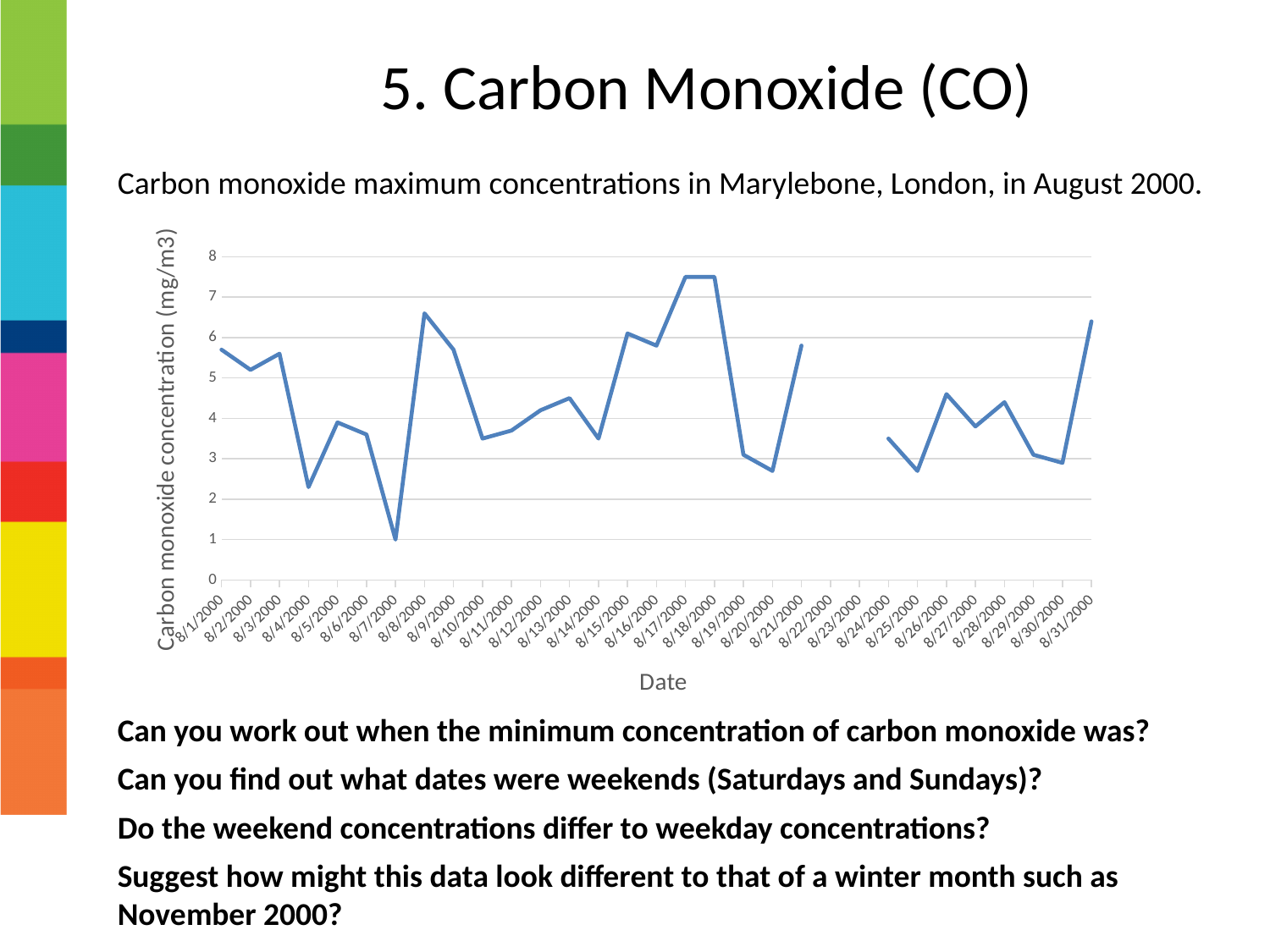
Is the value for 8/17/2000 greater or less than 7? greater What is the label of the y axis of the chart? Carbon monoxide concentration (mg/m3) Is the value for 8/7/2000 greater or less than 2? less Is the value for 8/4/2000 greater or less than 3? less Which date has the higher carbon monoxide concentration, 8/7/2000 or 8/8/2000? 8/8/2000 How many dates are shown on the x axis of the chart? 31 Which date has the higher carbon monoxide concentration, 8/1/2000 or 8/4/2000? 8/1/2000 On which date was the carbon monoxide concentration lowest? 8/7/2000 Does the carbon monoxide concentration rise or fall from 8/17/2000 to 8/19/2000? fall What kind of chart is shown on the slide? line chart